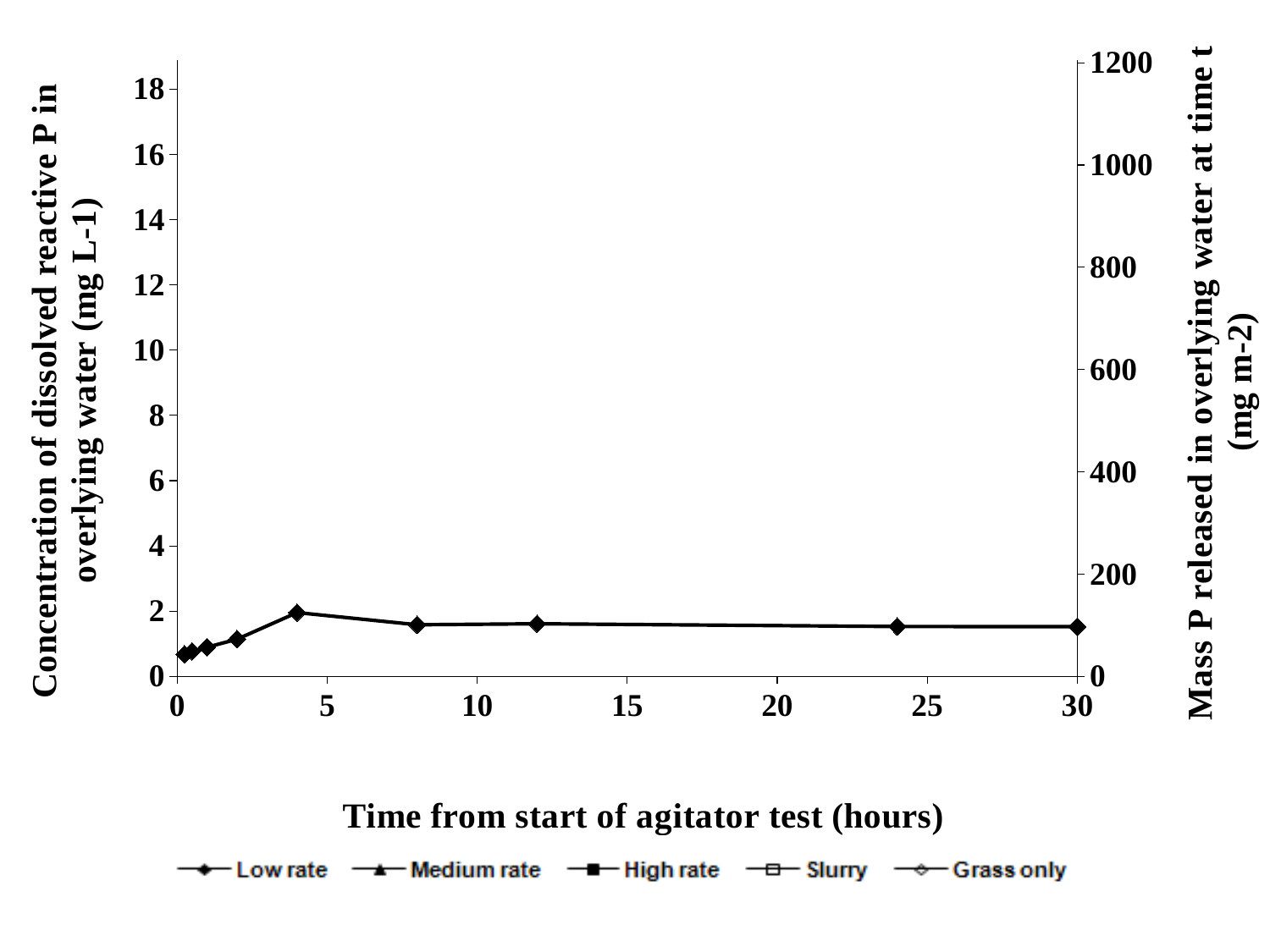
Does the Low rate series rise or fall between 4 and 8 hours? fall How many series does the legend list? 5 What is the highest tick value shown on the right-hand y axis? 1200 What is the title of the x axis? Time from start of agitator test (hours) At which time (hours) does the Low rate series reach its highest value? 4 Which is larger for the Low rate series: the value at 4 hours or the value at 30 hours? 4 hours Is the Low rate value at 4 hours greater or less than 1 mg L-1? greater Is the Low rate value at 0 hours greater or less than 2 mg L-1? less Does the Low rate series rise or fall between 0 and 4 hours? rise Is the Low rate value at 4 hours greater or less than 4 mg L-1? less What kind of chart is shown on the slide? line chart